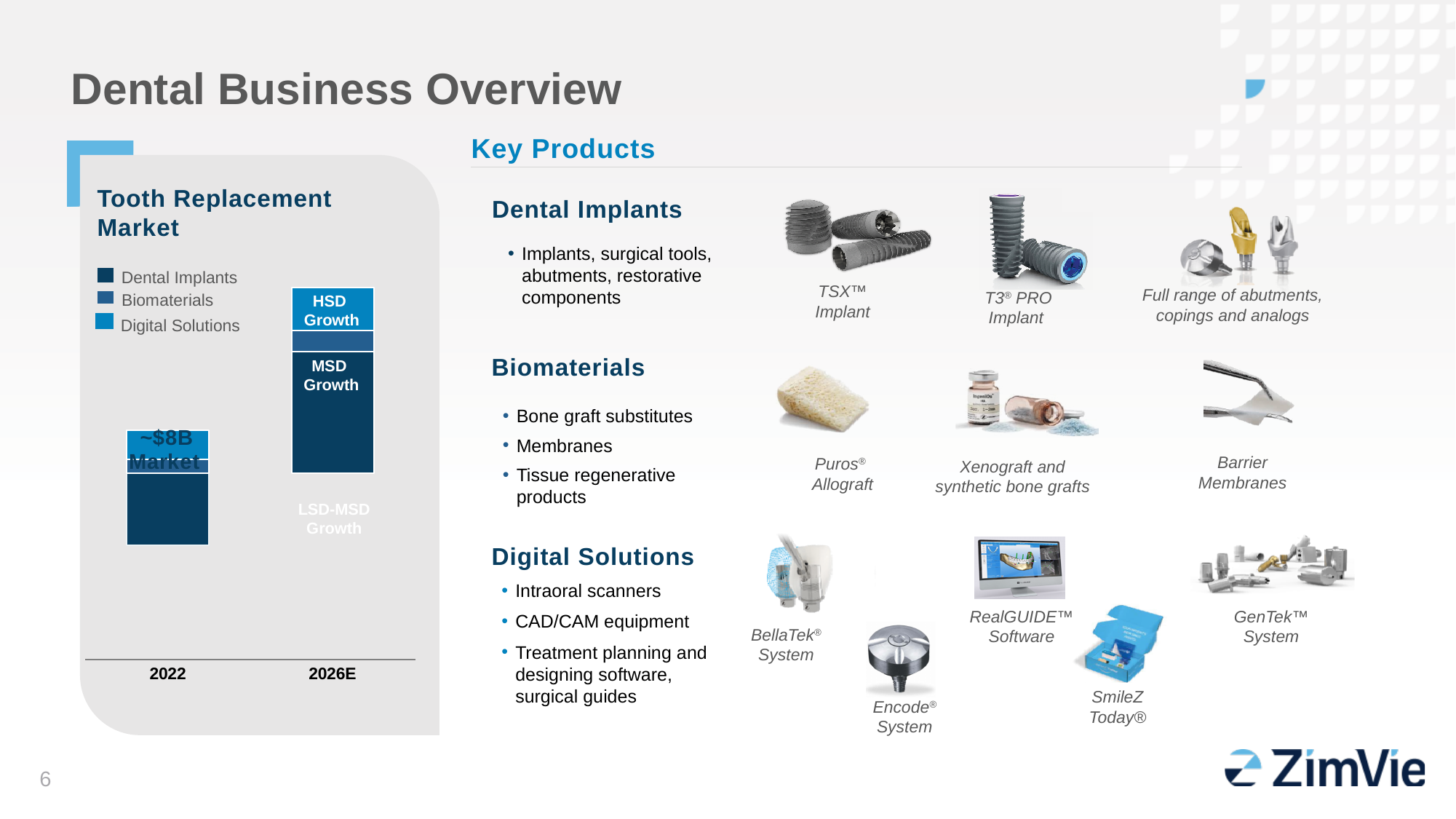
In the Tooth Replacement Market chart, which bar is taller, 2022 or 2026E? 2026E Which series are listed in the legend of the Tooth Replacement Market chart? Dental Implants, Biomaterials, Digital Solutions What type of chart is shown under "Tooth Replacement Market"? stacked bar chart Which category in the Tooth Replacement Market chart has the highest total bar? 2026E What are the two x-axis categories in the Tooth Replacement Market chart? 2022 and 2026E What growth label appears on the largest (bottom) segment of the 2026E bar in the Tooth Replacement Market chart? MSD Growth Does the total market size in the Tooth Replacement Market chart rise or fall from 2022 to 2026E? rise How many categories are shown on the x axis of the Tooth Replacement Market chart? 2 What label is printed on the 2022 bar of the Tooth Replacement Market chart? ~$8B Market What growth label appears on the top segment of the 2026E bar in the Tooth Replacement Market chart? HSD Growth Which category in the Tooth Replacement Market chart has the lowest total bar? 2022 How many series does the legend of the Tooth Replacement Market chart list? 3